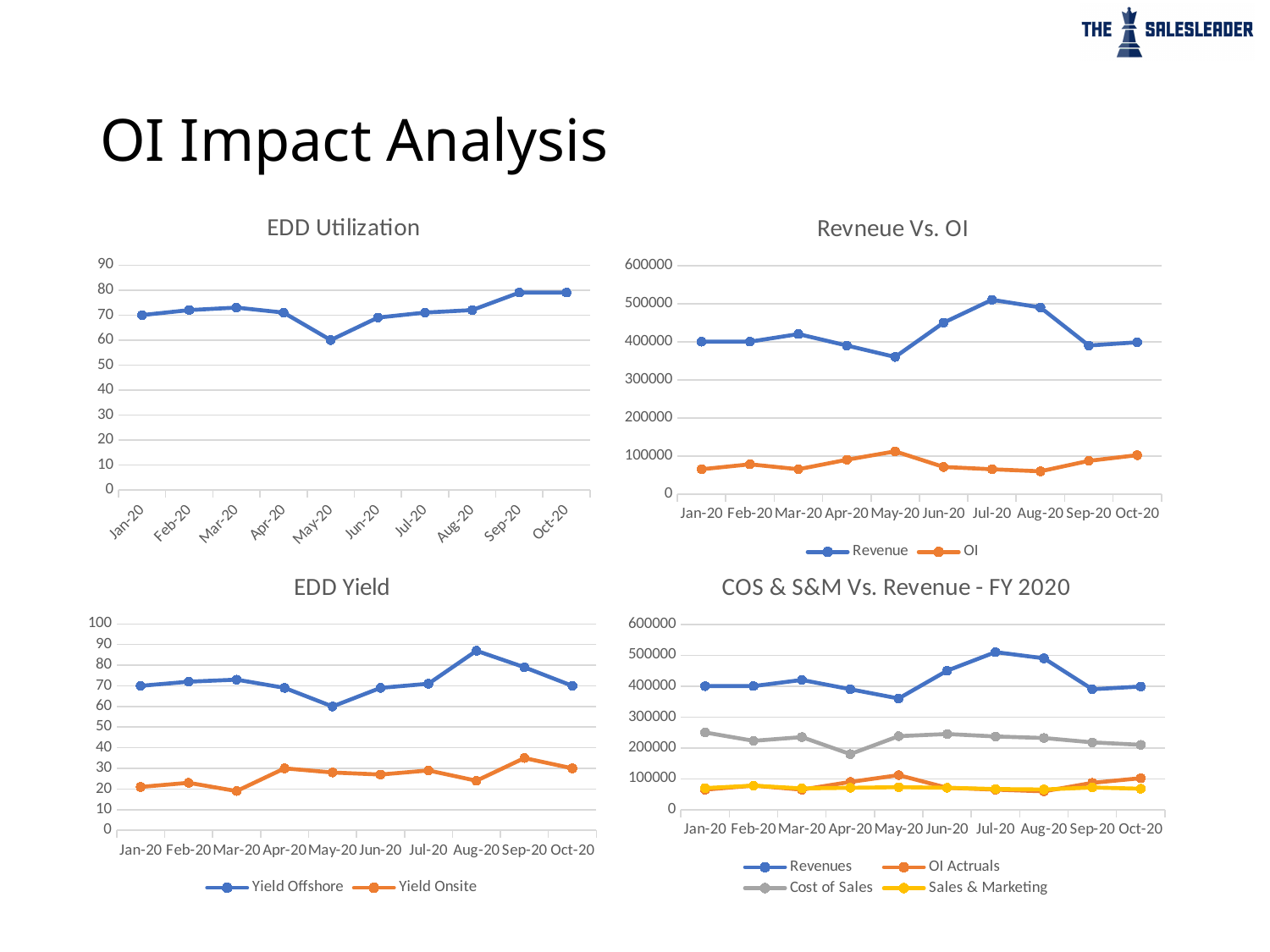
In the Revneue Vs. OI chart, is the Revenue value for May-20 greater or less than 400000? less In the EDD Yield chart, which is larger in Aug-20, Yield Offshore or Yield Onsite? Yield Offshore How many series does the legend of the COS & S&M Vs. Revenue - FY 2020 chart list? 4 In the EDD Utilization chart, which month has the lowest value? May-20 In the EDD Utilization chart, how many months are plotted along the x axis? 10 How many series does the legend of the Revneue Vs. OI chart list? 2 In the EDD Utilization chart, what is the value for May-20? 60 What kind of chart is the EDD Utilization chart? Line chart In the EDD Utilization chart, is the value for Sep-20 greater or less than 70? greater In the EDD Yield chart, in which month is Yield Offshore highest? Aug-20 In the Revneue Vs. OI chart, in which month is Revenue highest? Jul-20 In the COS & S&M Vs. Revenue - FY 2020 chart, in which month is Cost of Sales lowest? Apr-20